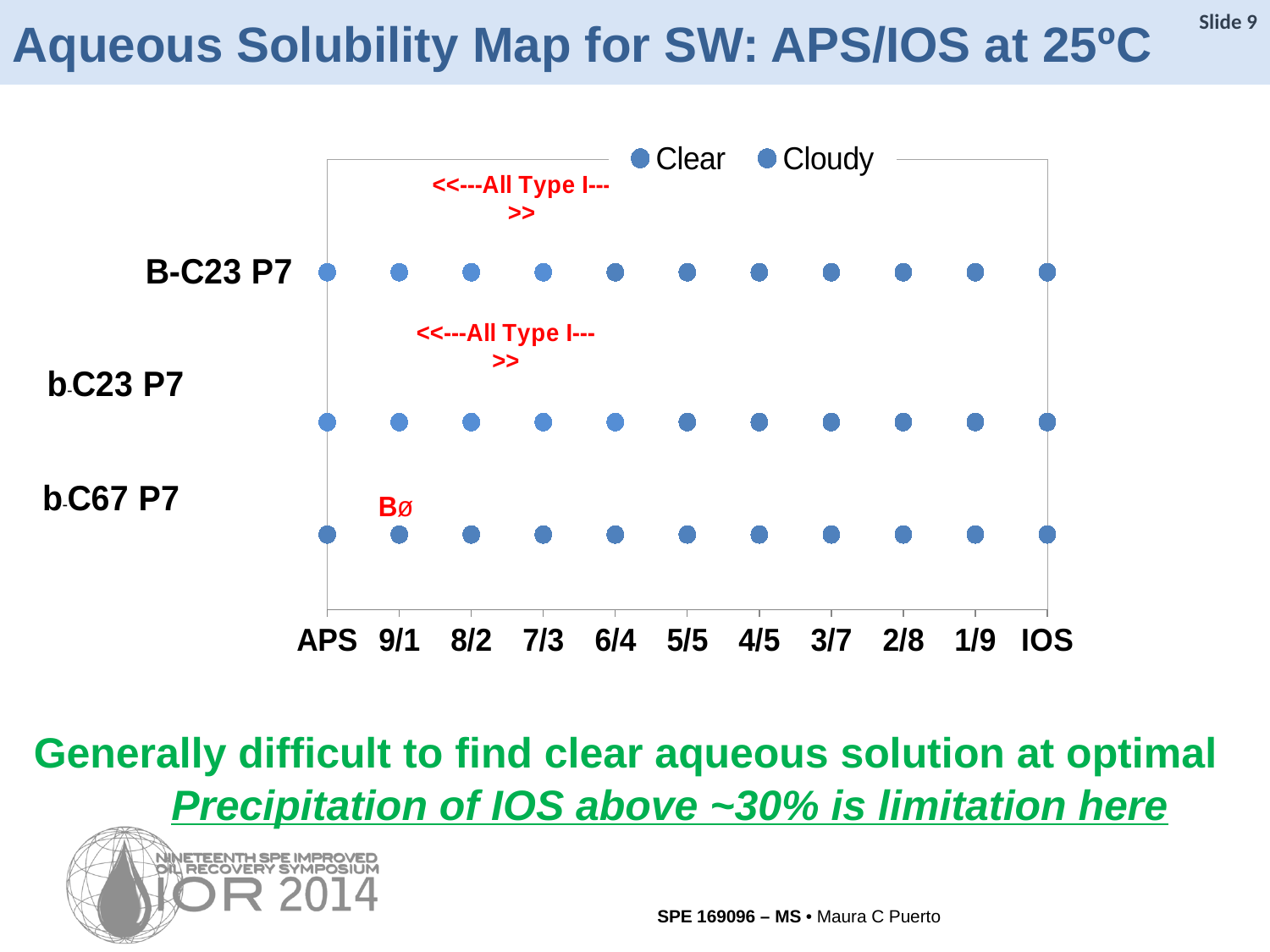
How many data points are plotted in the B-C23 P7 row? 11 How many data points are plotted in total across all three rows? 33 What is the last category label on the x axis? IOS How many categories are labelled along the x axis? 11 What is the title of the chart on the slide? Aqueous Solubility Map for SW: APS/IOS at 25ºC How many series does the legend list? 2 Which x-axis category comes immediately after 5/5? 4/5 What kind of chart is shown on the slide? Scatter (dot) chart Which x-axis category is labelled with the red annotation "BØ" in the b-C67 P7 row? 9/1 What is the first category label on the x axis? APS What are the two entries in the chart legend? Clear and Cloudy